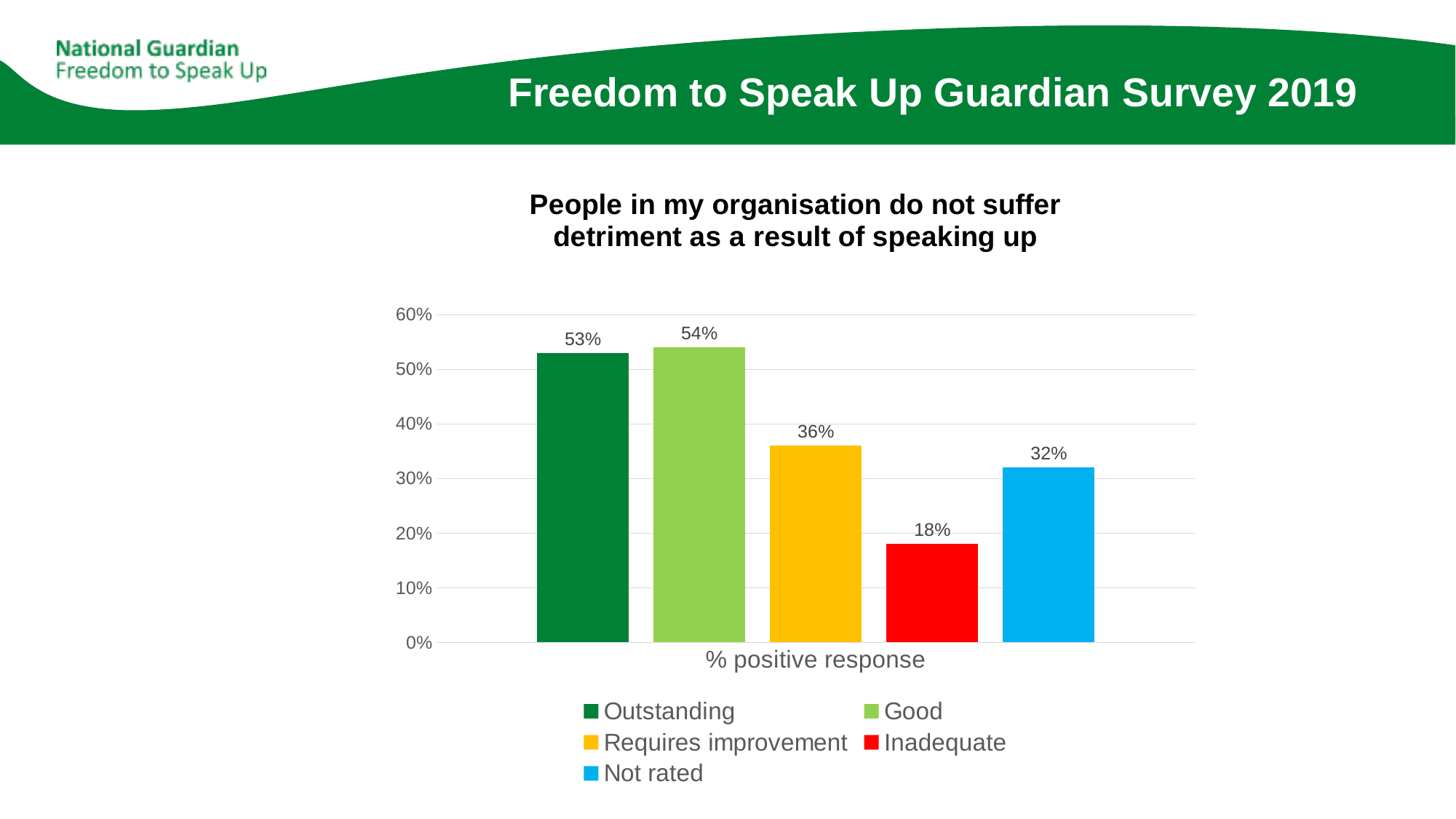
What is the % positive response for Inadequate? 18% What is the difference in % positive response between Requires improvement and Inadequate? 18% How many series does the legend list? 5 Which has a higher % positive response, Requires improvement or Not rated? Requires improvement What is the % positive response for Good? 54% What kind of chart is shown on the slide? Bar chart Which series has the lowest % positive response? Inadequate Is the value for Outstanding greater or less than 50%? greater What is the title of the chart? People in my organisation do not suffer detriment as a result of speaking up Which series has the highest % positive response? Good What is the difference in % positive response between Outstanding and Not rated? 21% What is the % positive response for Not rated? 32%